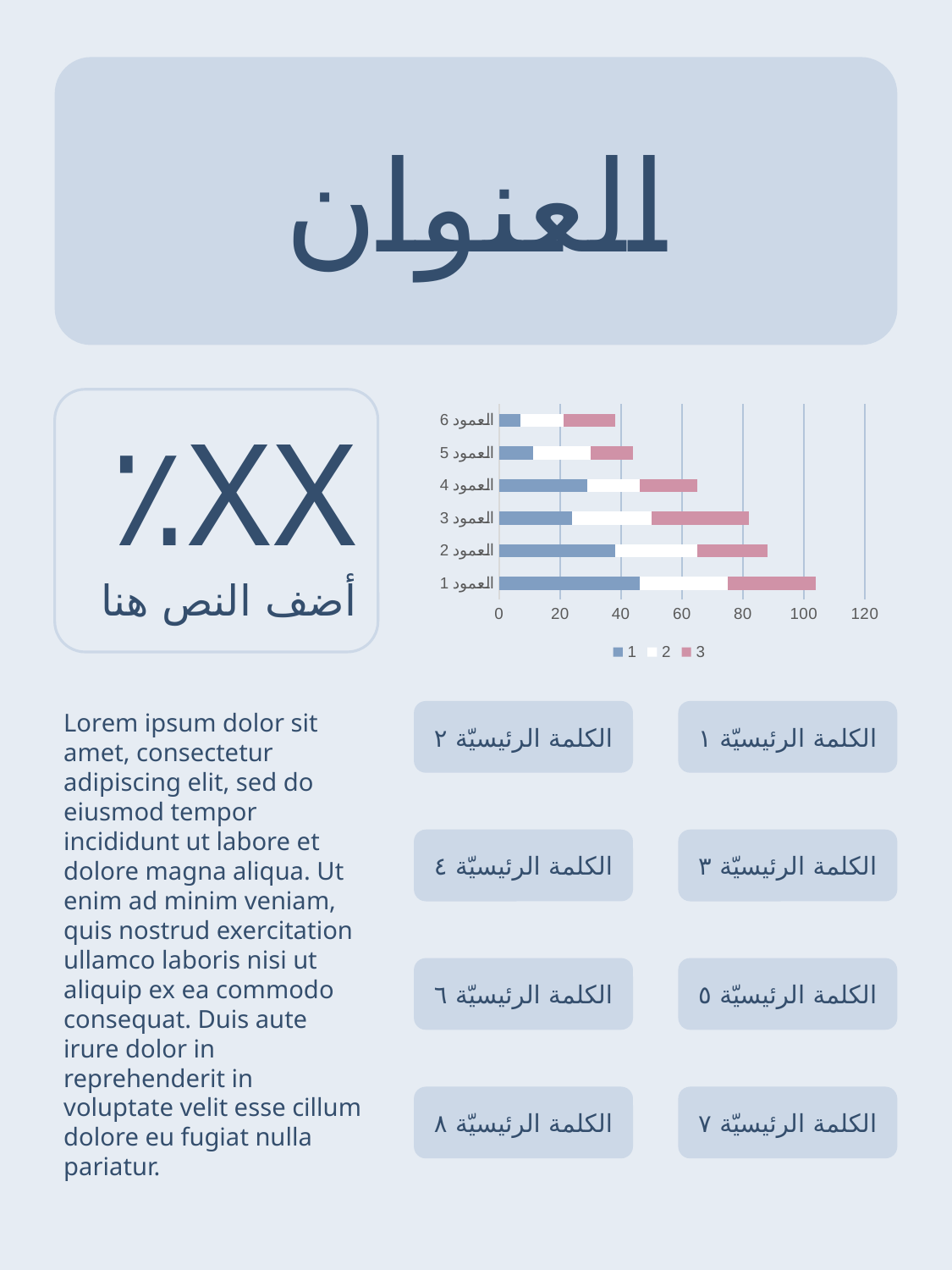
Is the total bar length for العمود 6 greater or less than 60? less Which total bar is longer, العمود 2 or العمود 5? العمود 2 Which total bar is longer, العمود 1 or العمود 4? العمود 1 Which category has the longest total bar? العمود 1 What are the entries listed in the chart's legend? 1, 2, 3 Is the value of series 1 for العمود 1 greater or less than 20? greater Is the total bar length for العمود 4 greater or less than 40? greater How many series does the chart's legend list? 3 Do the total bar lengths rise or fall going from العمود 1 to العمود 6? fall How many categories (العمود bars) does the chart show? 6 What kind of chart is shown on the slide? Stacked bar chart